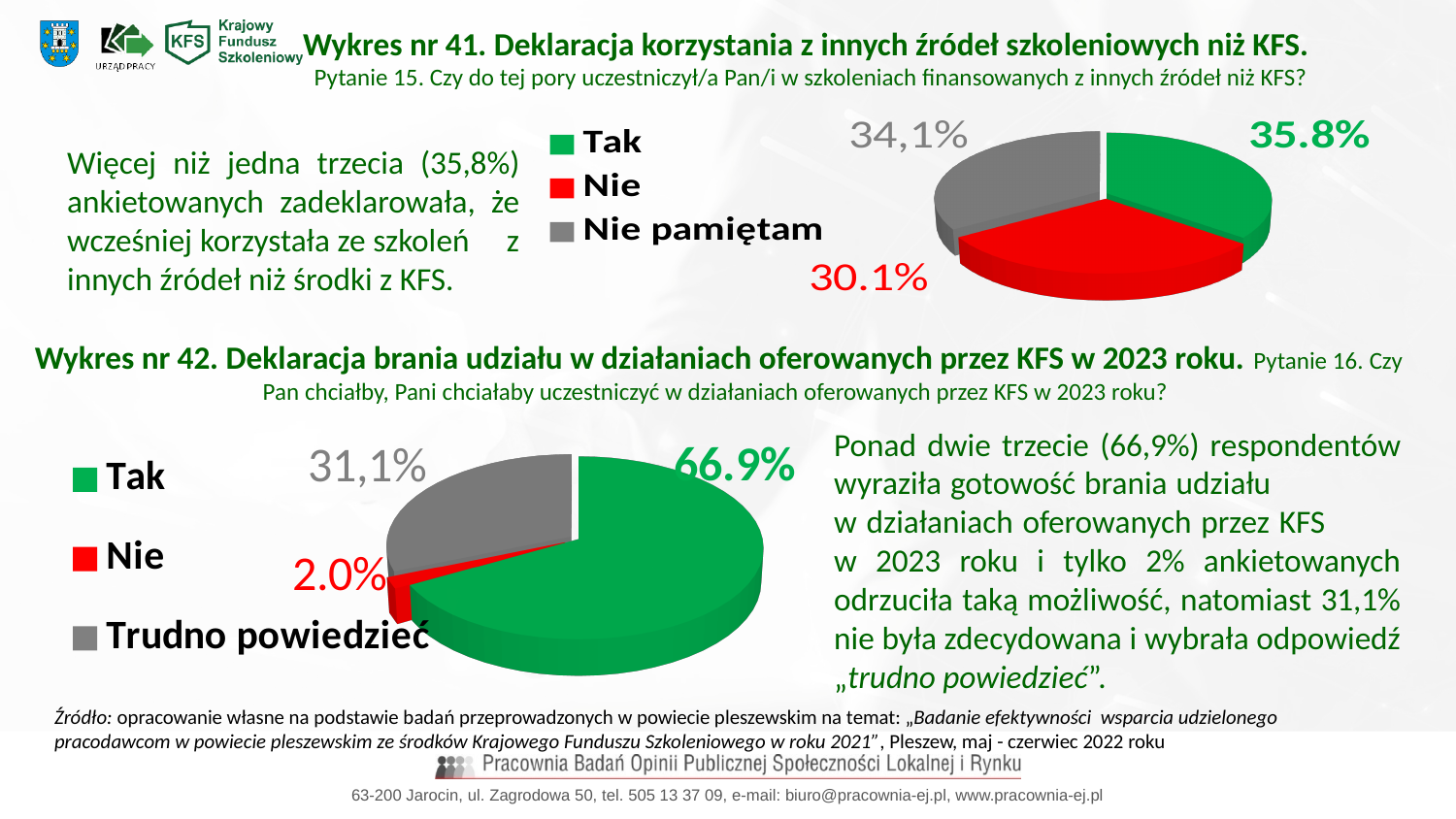
What type of chart is Wykres nr 42 (bottom chart)? Pie chart In Wykres nr 42 (bottom chart), what share of respondents answered "Trudno powiedzieć"? 31,1% In Wykres nr 42 (bottom chart), what share of respondents answered "Nie"? 2.0% In Wykres nr 42 (bottom chart), which answer has the smallest share? Nie In Wykres nr 41 (top chart), which answer has the smallest share? Nie In Wykres nr 41 (top chart), what share of respondents answered "Nie pamiętam"? 34,1% In Wykres nr 41 (top chart), how many entries does the legend list? 3 In Wykres nr 42 (bottom chart), what share of respondents answered "Tak"? 66.9% In Wykres nr 42 (bottom chart), which is larger: the share for "Tak" or the share for "Trudno powiedzieć"? Tak In Wykres nr 41 (top chart), which answer has the largest share? Tak In Wykres nr 41 (top chart), what share of respondents answered "Tak"? 35.8% In Wykres nr 41 (top chart), what share of respondents answered "Nie"? 30.1%